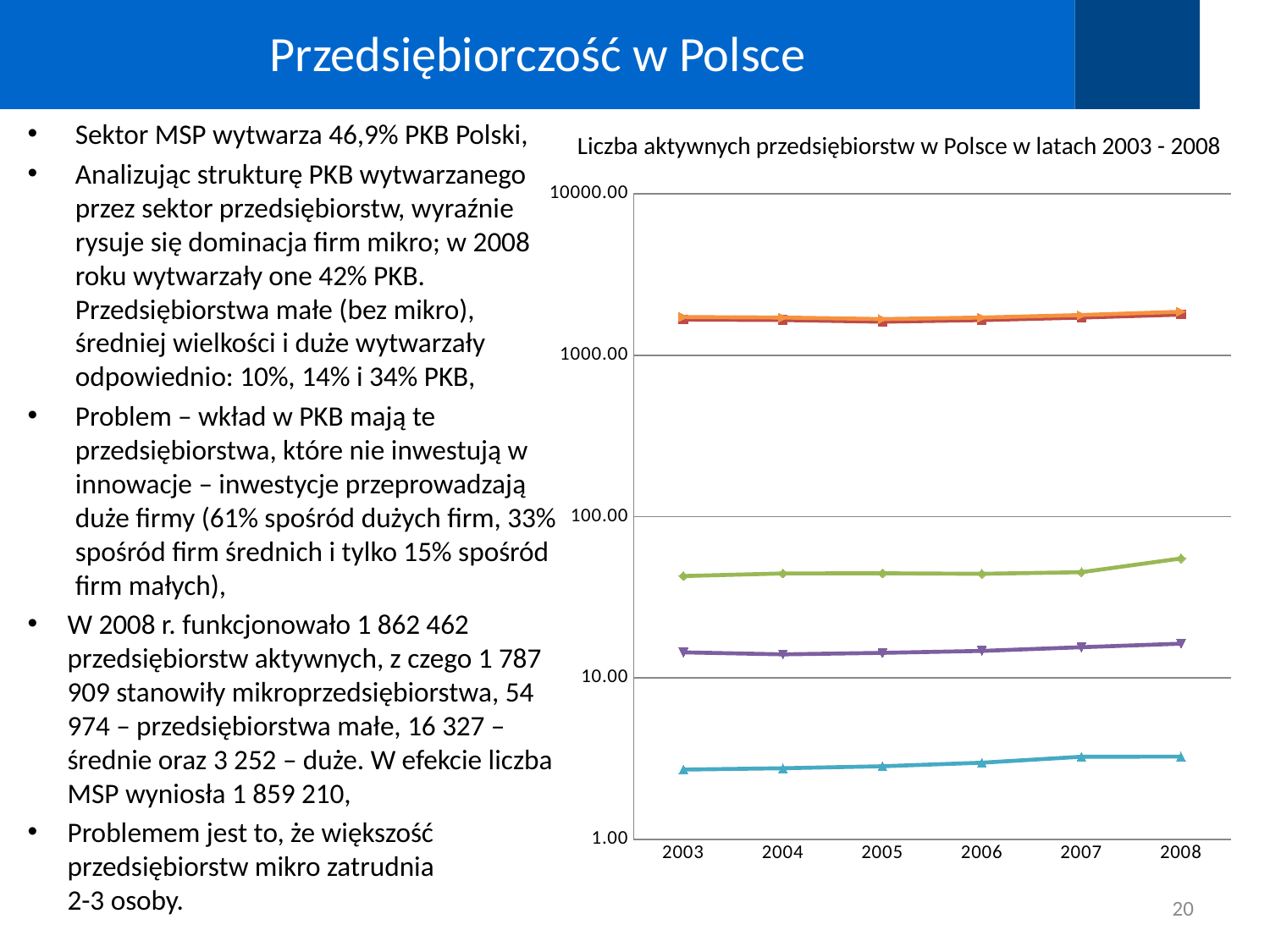
Is the value of the orange line in 2008 greater or less than 1000.00? greater Does the blue line rise or fall from 2003 to 2008? rise What is the title of the chart? Liczba aktywnych przedsiębiorstw w Polsce w latach 2003 - 2008 What kind of chart is shown on the slide? line chart Which line lies lowest on the chart across all years? the blue line Is the value of the purple line in 2008 greater or less than 10.00? greater How many years are shown on the x axis of the chart? 6 Is the value of the green line in 2008 greater or less than 100.00? less Does the green line rise or fall between 2007 and 2008? rise What is the first year shown on the x axis of the chart? 2003